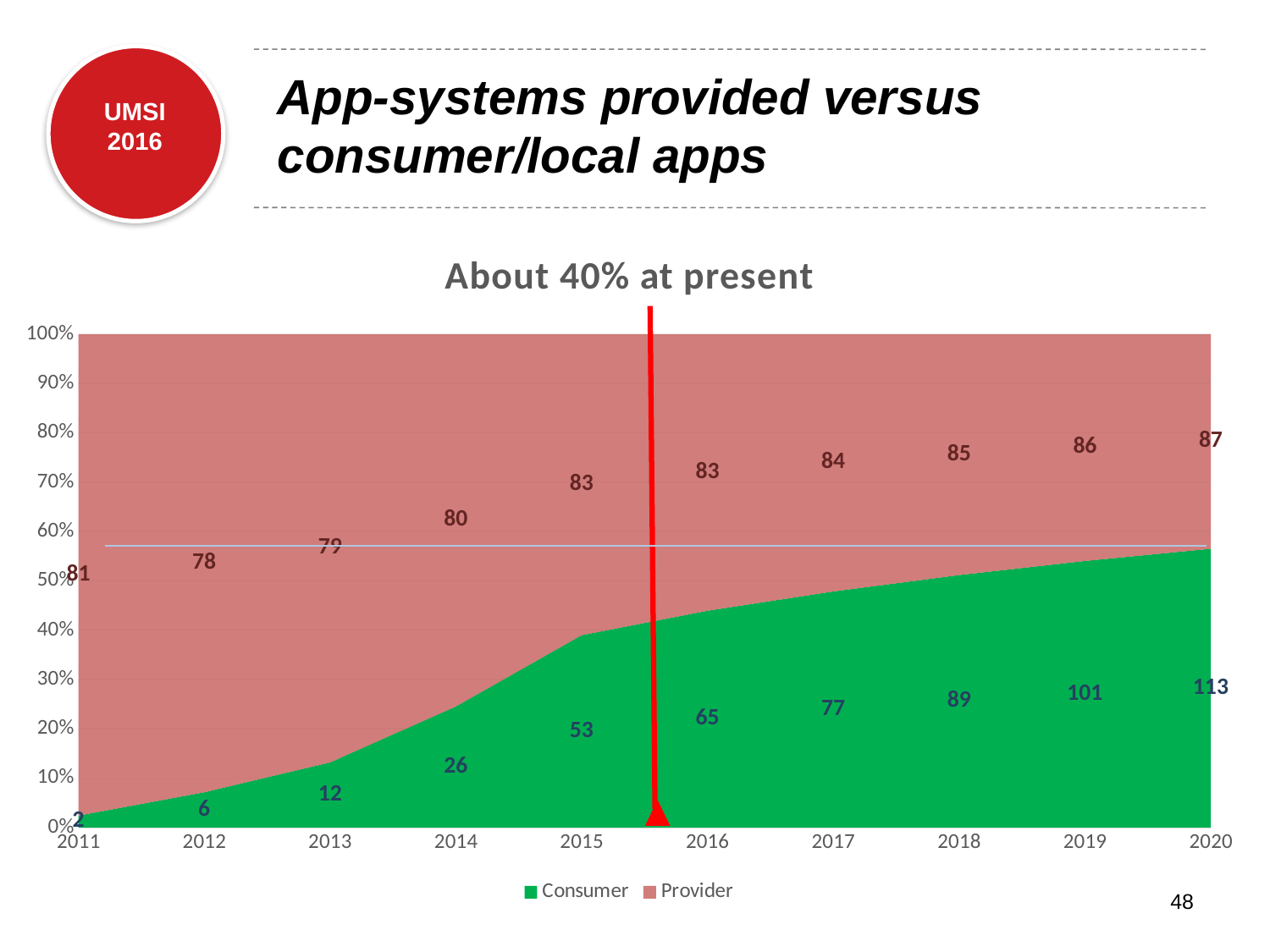
What kind of chart is shown on the slide? area chart Does the Consumer value rise or fall from 2011 to 2020? rise What is the Consumer value for 2015? 53 In which year is the Consumer value highest? 2020 In which year is the Provider value lowest? 2012 How many years are shown on the x axis? 10 What is the chart's title? About 40% at present How many series does the legend list? 2 What is the difference between the Consumer values for 2020 and 2011? 111 What is the Provider value for 2011? 81 What is the Provider value for 2020? 87 In 2018, which is larger, the Consumer value or the Provider value? Consumer